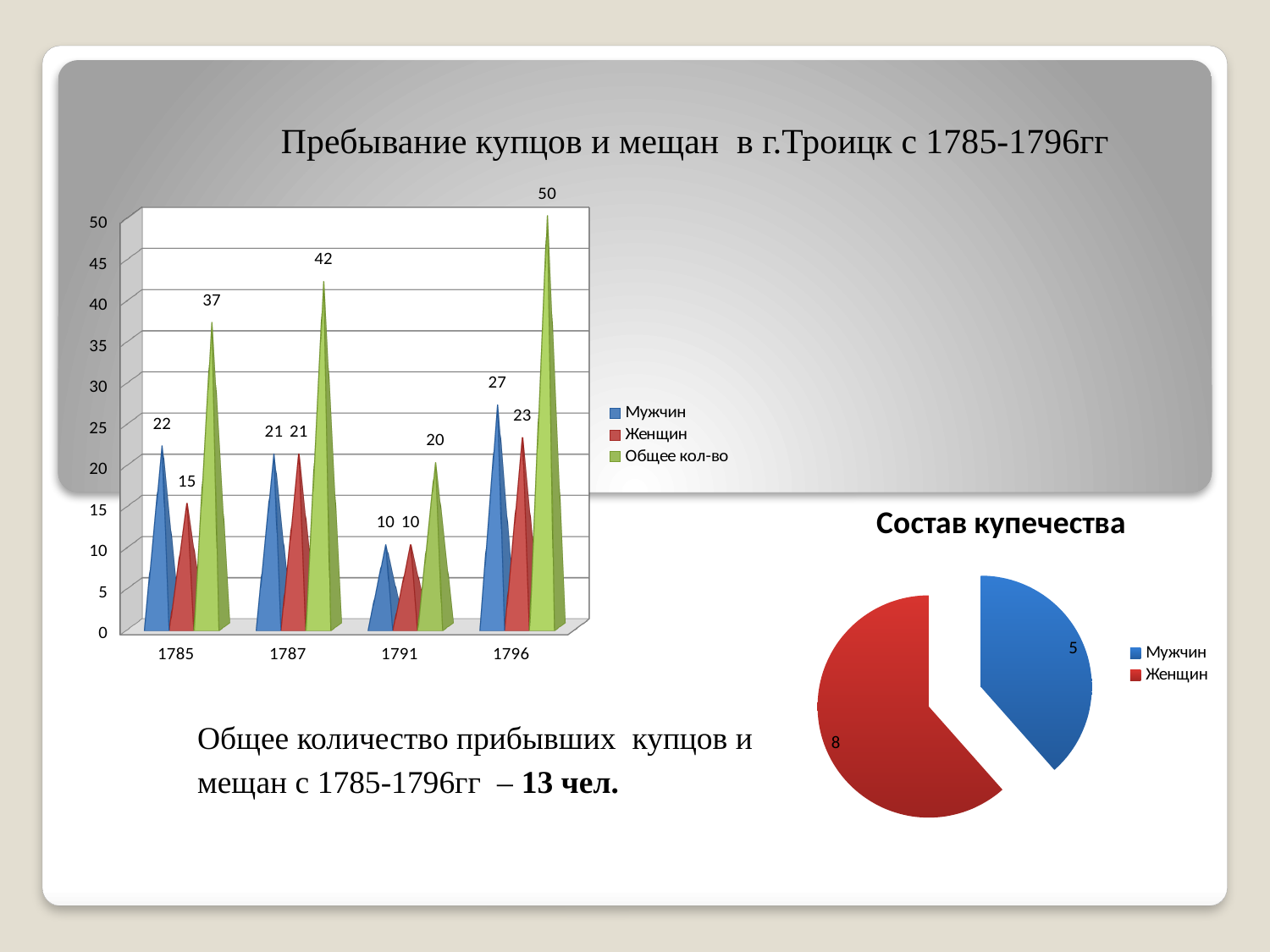
In the bar chart 'Пребывание купцов и мещан в г.Троицк с 1785-1796гг', what is the value for Мужчин in 1785? 22 In the bar chart 'Пребывание купцов и мещан в г.Троицк с 1785-1796гг', which year has the lowest value for Мужчин? 1791 In the bar chart 'Пребывание купцов и мещан в г.Троицк с 1785-1796гг', which year has the highest Общее кол-во? 1796 In the pie chart 'Состав купечества', what is the value for Женщин? 8 In the pie chart 'Состав купечества', which slice is larger, Мужчин or Женщин? Женщин How many series does the legend of the bar chart 'Пребывание купцов и мещан в г.Троицк с 1785-1796гг' list? 3 How many years are shown on the x axis of the bar chart 'Пребывание купцов и мещан в г.Троицк с 1785-1796гг'? 4 In the bar chart 'Пребывание купцов и мещан в г.Троицк с 1785-1796гг', is the value for Мужчин in 1796 larger or smaller than the value for Мужчин in 1787? larger In the bar chart 'Пребывание купцов и мещан в г.Троицк с 1785-1796гг', what is the difference between Мужчин and Женщин in 1785? 7 What kind of chart is 'Состав купечества'? pie chart In the bar chart 'Пребывание купцов и мещан в г.Троицк с 1785-1796гг', what is the value for Общее кол-во in 1787? 42 In the bar chart 'Пребывание купцов и мещан в г.Троицк с 1785-1796гг', what is the value for Женщин in 1796? 23